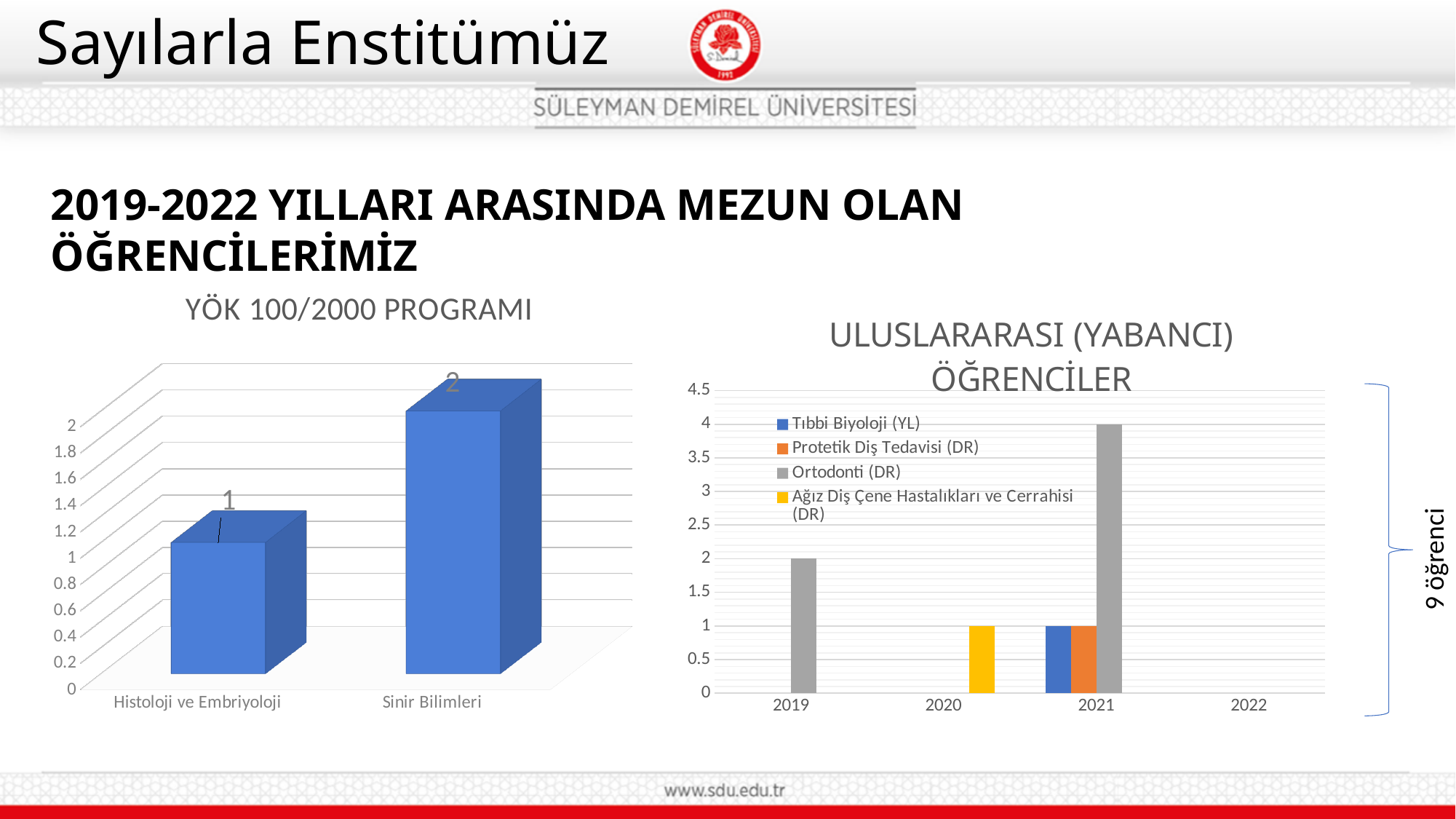
In the YÖK 100/2000 PROGRAMI chart, how many categories are shown on the x axis? 2 In the YÖK 100/2000 PROGRAMI chart, what is the value for Sinir Bilimleri? 2 What kind of chart is the YÖK 100/2000 PROGRAMI chart? Bar chart In the ULUSLARARASI (YABANCI) ÖĞRENCİLER chart, how many series does the legend list? 4 In the ULUSLARARASI (YABANCI) ÖĞRENCİLER chart, which year has the tallest bar? 2021 In the ULUSLARARASI (YABANCI) ÖĞRENCİLER chart, is the Ortodonti (DR) value for 2021 greater or less than 3? greater In the ULUSLARARASI (YABANCI) ÖĞRENCİLER chart, how many years are shown on the x axis? 4 In the ULUSLARARASI (YABANCI) ÖĞRENCİLER chart, is the Ortodonti (DR) value for 2019 greater or less than 3? less In the ULUSLARARASI (YABANCI) ÖĞRENCİLER chart, which series is shown in yellow? Ağız Diş Çene Hastalıkları ve Cerrahisi (DR) In the YÖK 100/2000 PROGRAMI chart, what is the difference between Sinir Bilimleri and Histoloji ve Embriyoloji? 1 In the YÖK 100/2000 PROGRAMI chart, what is the value for Histoloji ve Embriyoloji? 1 In the YÖK 100/2000 PROGRAMI chart, which category has the highest value? Sinir Bilimleri